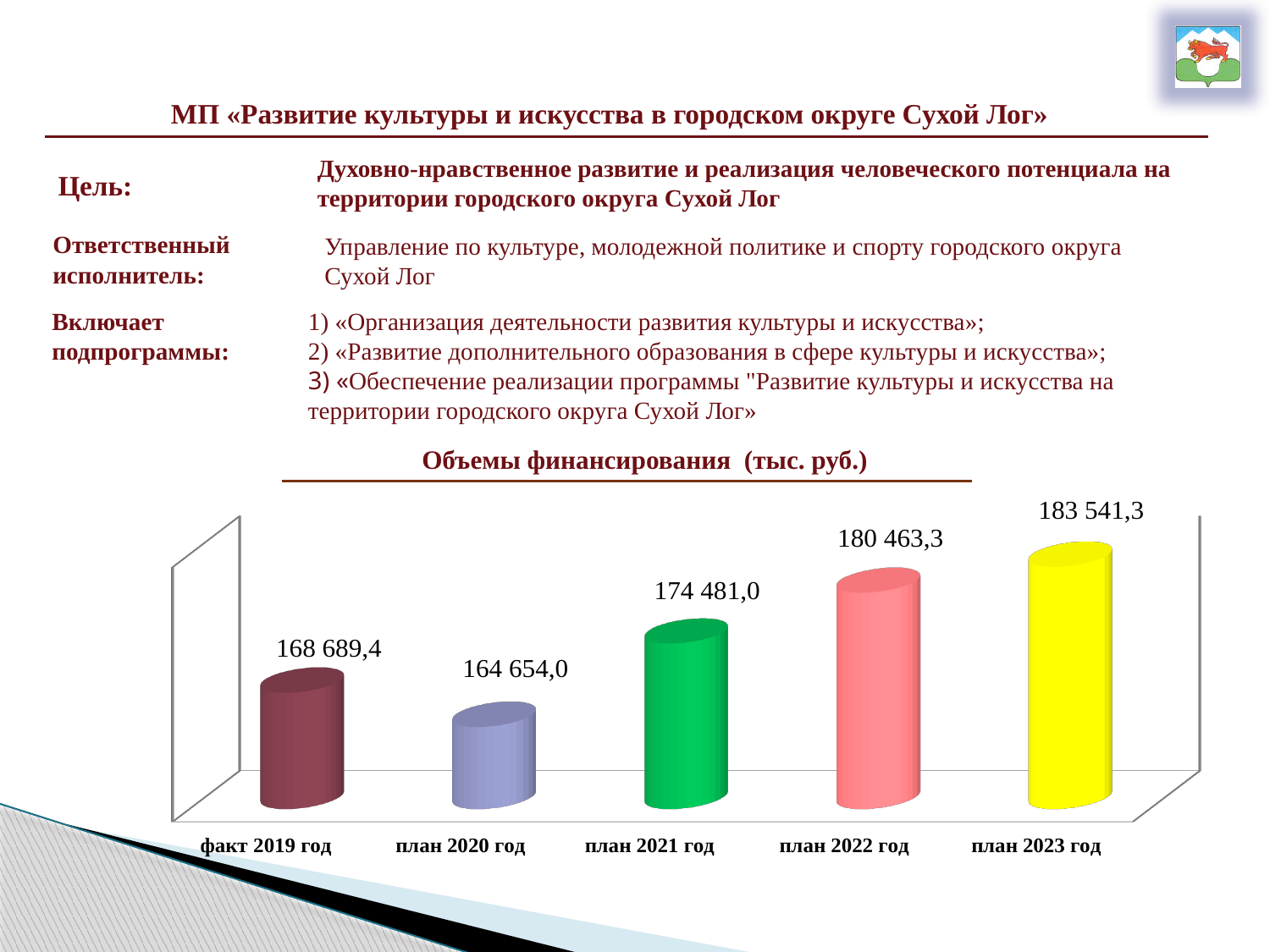
What kind of chart is shown on the slide? bar chart Which is larger, the value for факт 2019 год or the value for план 2020 год? факт 2019 год What is the difference between the values for план 2023 год and план 2022 год? 3 078,0 Which category has the highest value in the chart? план 2023 год What is the value for план 2021 год in the chart 'Объемы финансирования (тыс. руб.)'? 174 481,0 What is the value for факт 2019 год in the chart? 168 689,4 Do the values rise or fall from план 2020 год to план 2023 год? rise What is the value for план 2023 год in the chart? 183 541,3 What is the value for план 2020 год in the chart? 164 654,0 Which category has the lowest value in the chart? план 2020 год What is the difference between the values for факт 2019 год and план 2020 год? 4 035,4 How many categories are shown in the chart? 5